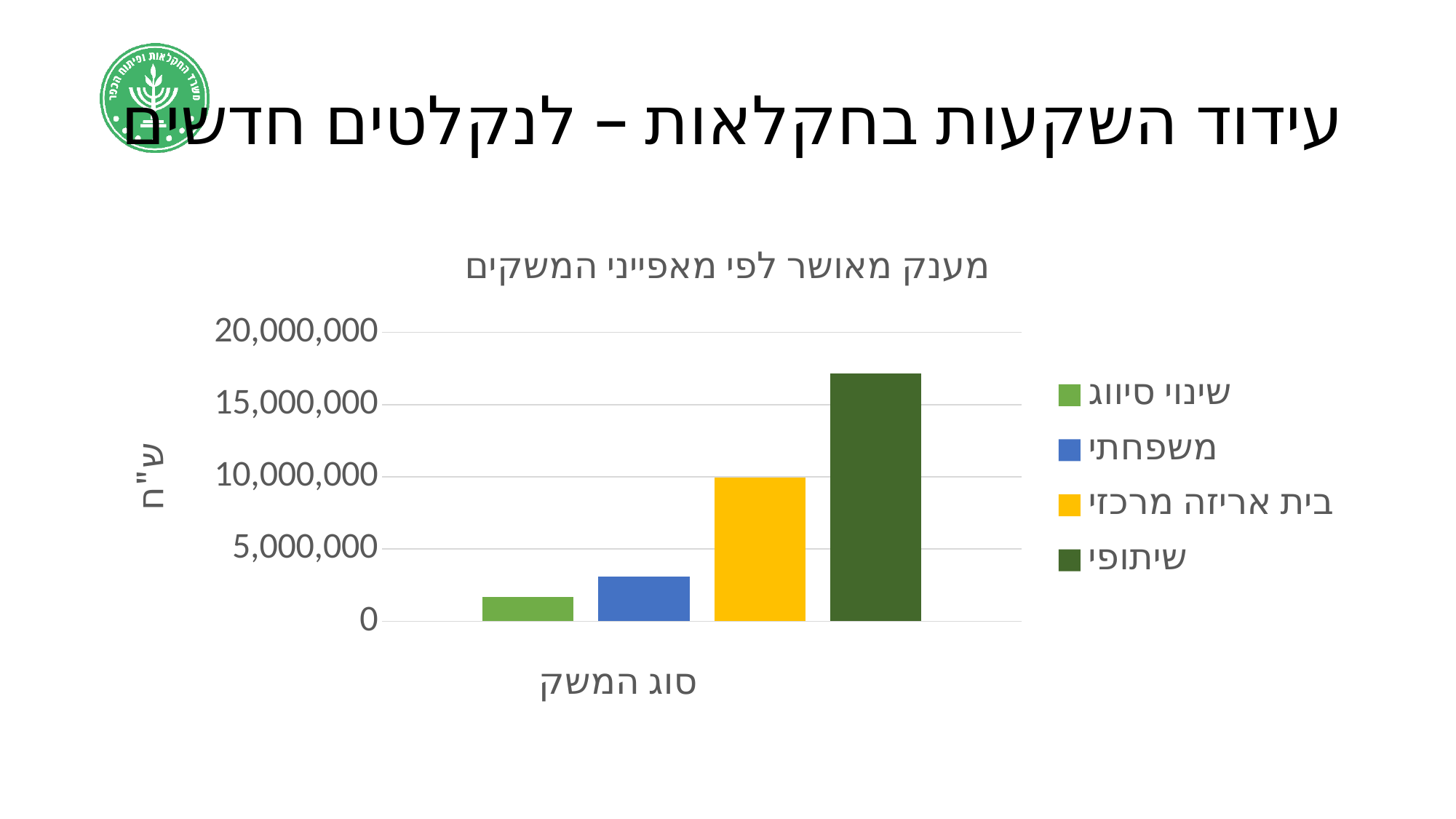
Is the value for שיתופי greater or less than 15,000,000? greater Is the value for שינוי סיווג greater or less than 5,000,000? less Is the value for משפחתי greater or less than 5,000,000? less Which is larger, the value for משפחתי or the value for שינוי סיווג? משפחתי What kind of chart is shown on the slide? bar chart Which series has the highest value? שיתופי Which series has the lowest value? שינוי סיווג What is the title of the chart? מענק מאושר לפי מאפייני המשקים What is the label on the vertical axis of the chart? ש"ח How many series does the legend list? 4 How many bars are plotted in the chart? 4